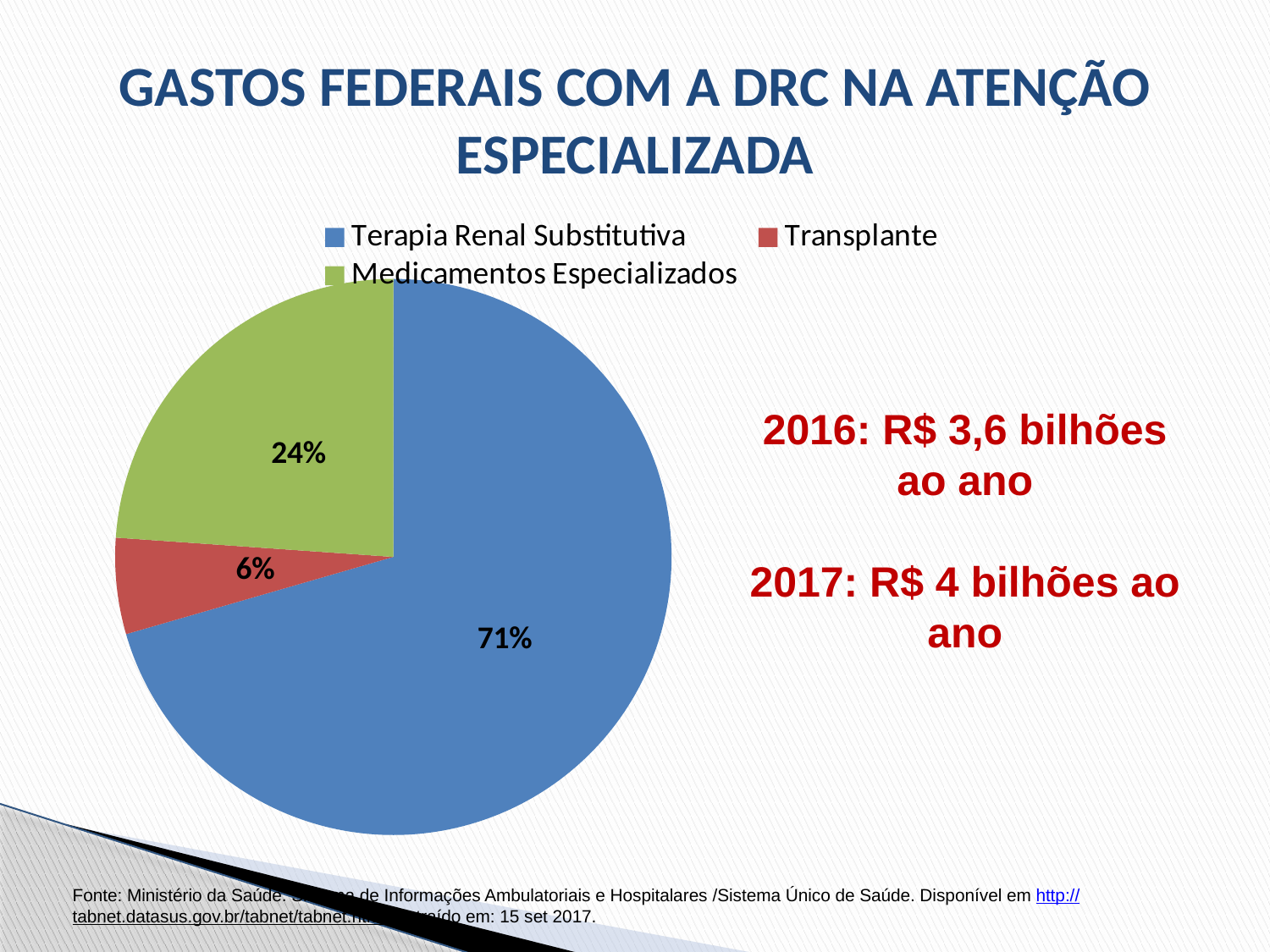
What colour is the slice for Transplante? red What share of the pie does Terapia Renal Substitutiva represent? 71% How many entries does the legend list? 3 Which is larger, the share for Medicamentos Especializados or the share for Transplante? Medicamentos Especializados What is the title of the slide containing the pie chart? GASTOS FEDERAIS COM A DRC NA ATENÇÃO ESPECIALIZADA Which category has the largest slice of the pie? Terapia Renal Substitutiva What kind of chart is shown on the slide? pie chart What is the difference in percentage points between Terapia Renal Substitutiva and Medicamentos Especializados? 47 What share of the pie does Medicamentos Especializados represent? 24% How many categories does the pie chart show? 3 Which category has the smallest slice of the pie? Transplante What share of the pie does Transplante represent? 6%